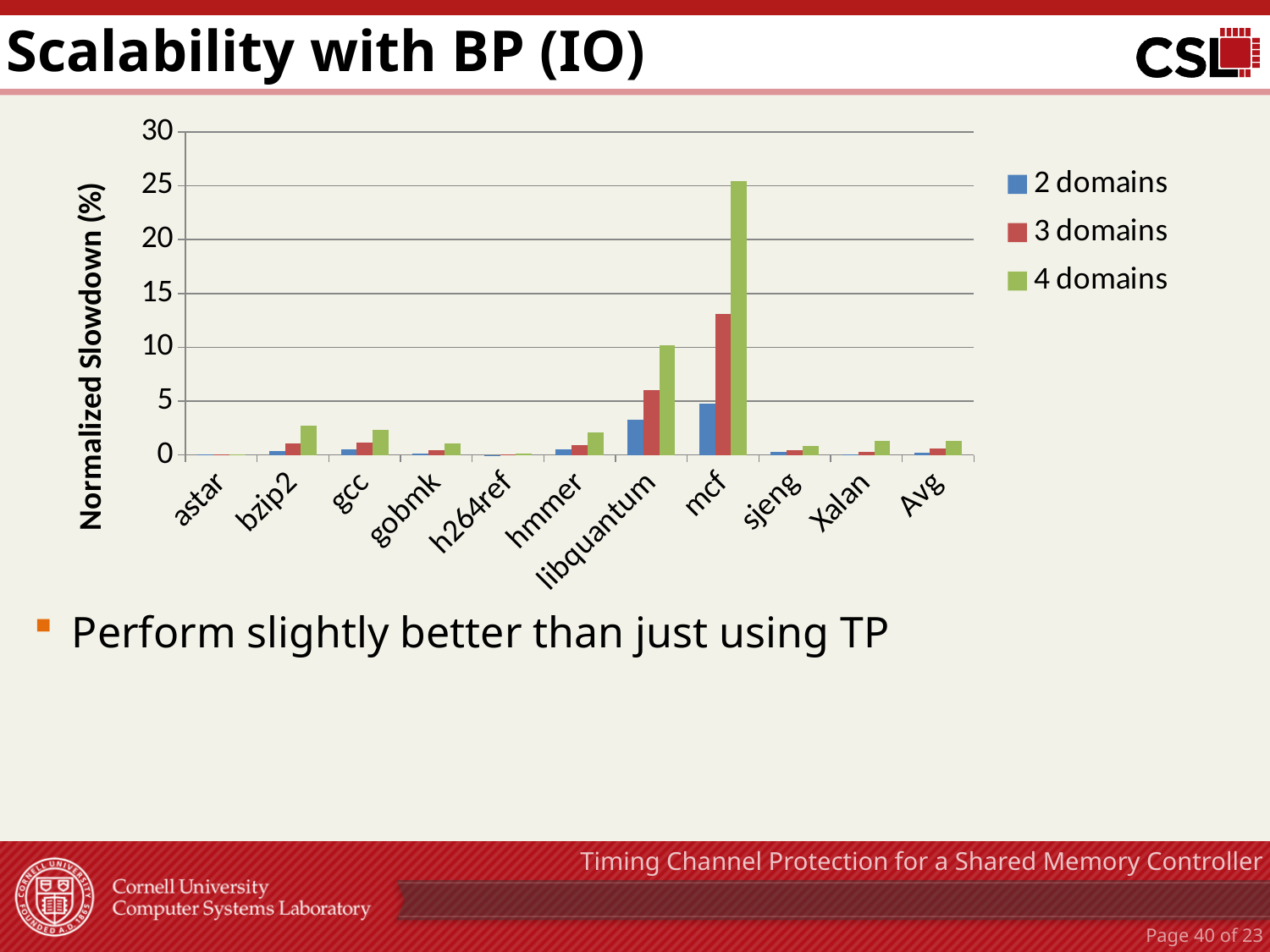
Which category has the highest normalized slowdown for 4 domains? mcf Is the 3 domains value for mcf greater or less than 10? greater Is the 2 domains value for libquantum greater or less than 5? less For 4 domains, which has the larger normalized slowdown, mcf or libquantum? mcf Which colour represents the 4 domains series in the legend? green Is the 4 domains value for mcf greater or less than 20? greater Which category has the highest normalized slowdown for 3 domains? mcf What type of chart is shown on the slide? bar chart How many series does the legend list? 3 What is the label of the y axis? Normalized Slowdown (%) How many benchmark categories are shown on the x axis? 11